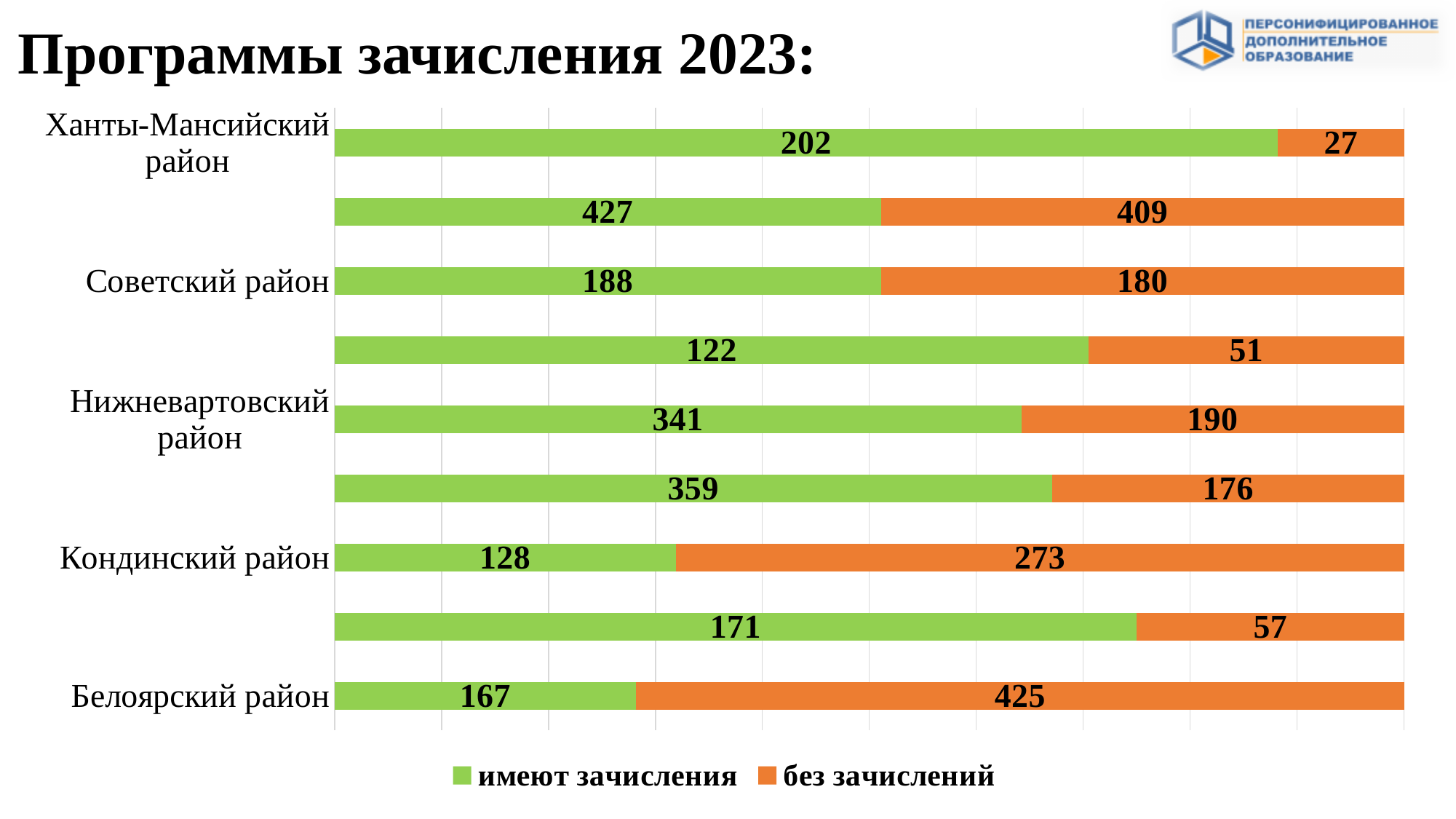
What kind of chart is shown on the slide? Stacked bar chart Which is larger in Нижневартовский район: 'имеют зачисления' or 'без зачислений'? имеют зачисления What is the value for 'имеют зачисления' in Кондинский район? 128 Among the labelled districts, which has the highest 'без зачислений' value? Белоярский район Among the labelled districts, which has the lowest 'имеют зачисления' value? Кондинский район How many series does the legend list? 2 What is the value for 'имеют зачисления' in Советский район? 188 What is the value for 'без зачислений' in Ханты-Мансийский район? 27 What is the value for 'имеют зачисления' in Нижневартовский район? 341 What is the total of the two segments for Белоярский район? 592 What is the difference between 'имеют зачисления' and 'без зачислений' in Кондинский район? 145 What is the value for 'без зачислений' in Белоярский район? 425